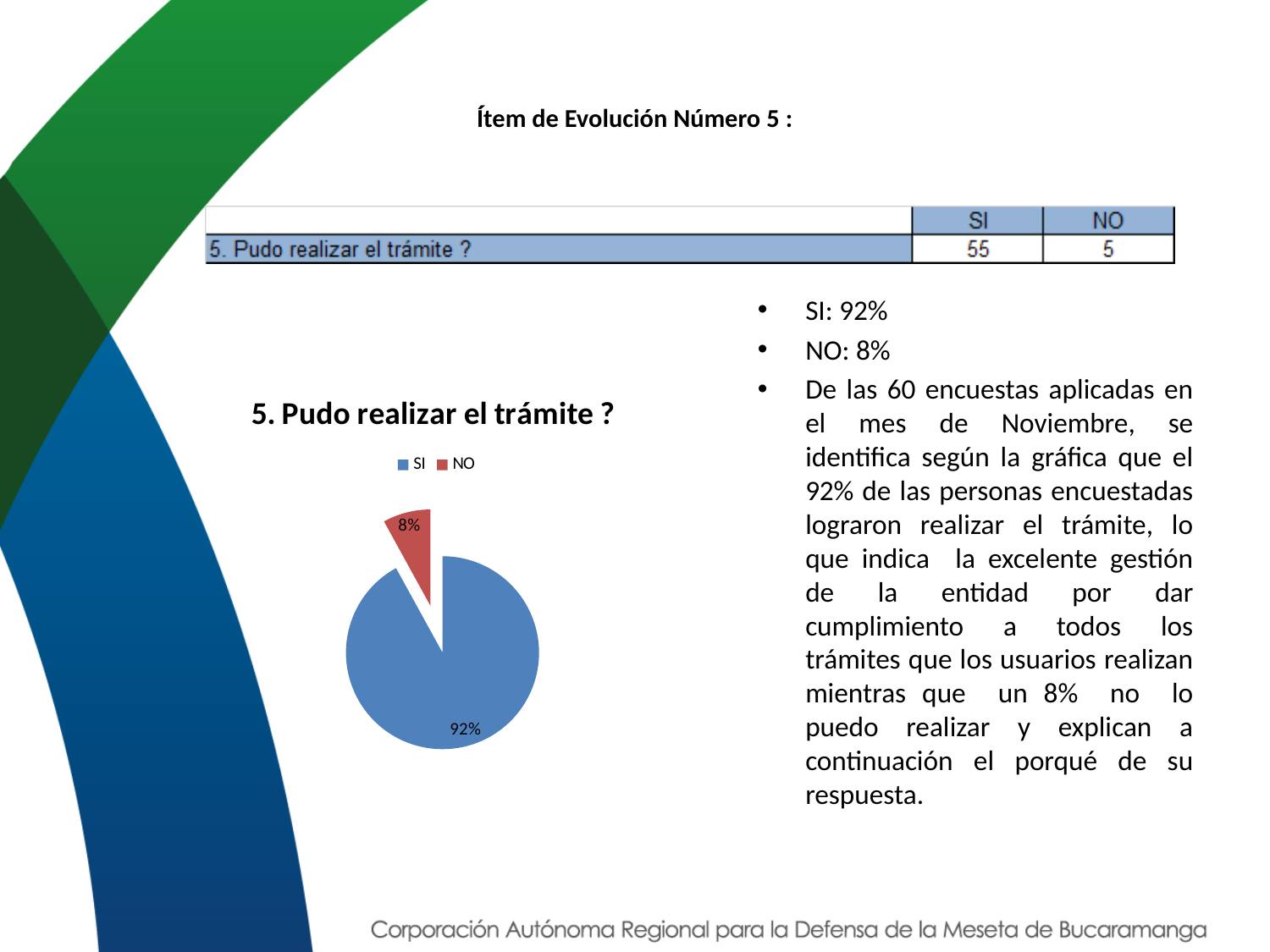
Which slice of the pie chart is the smallest? NO What is the title of the pie chart? 5. Pudo realizar el trámite ? Which slice of the pie chart is the largest? SI What colour is the NO slice in the pie chart? red How many entries does the legend of the pie chart list? 2 What share of the pie does the SI slice represent? 92% What share of the pie does the NO slice represent? 8% What kind of chart is shown on the slide? pie chart Which is larger in the pie chart, SI or NO? SI What is the difference in percentage points between the SI and NO slices? 84% How many slices does the pie chart have? 2